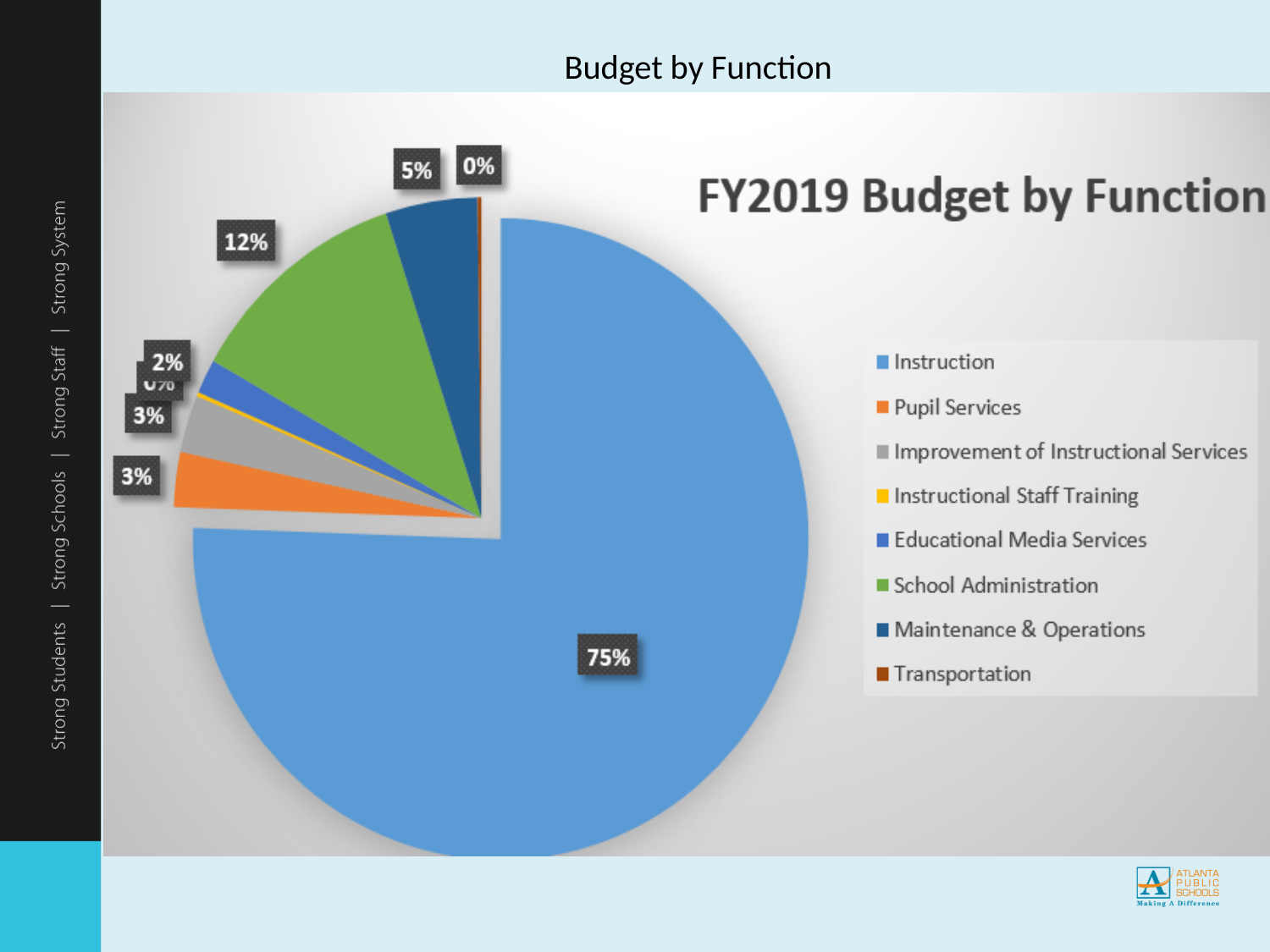
Which has a larger share of the budget, School Administration or Maintenance & Operations? School Administration What share of the FY2019 budget goes to Educational Media Services? 2% What share of the FY2019 budget goes to Maintenance & Operations? 5% Which function has the largest share of the FY2019 budget? Instruction What share of the FY2019 budget goes to Instruction? 75% How many percentage points larger is the Instruction share than the School Administration share? 63 What share of the FY2019 budget goes to Transportation? 0% What kind of chart is shown on the slide? pie chart What is the title of the chart? FY2019 Budget by Function What share of the FY2019 budget goes to School Administration? 12% What share of the FY2019 budget goes to Pupil Services? 3% How many functions are listed in the chart legend? 8